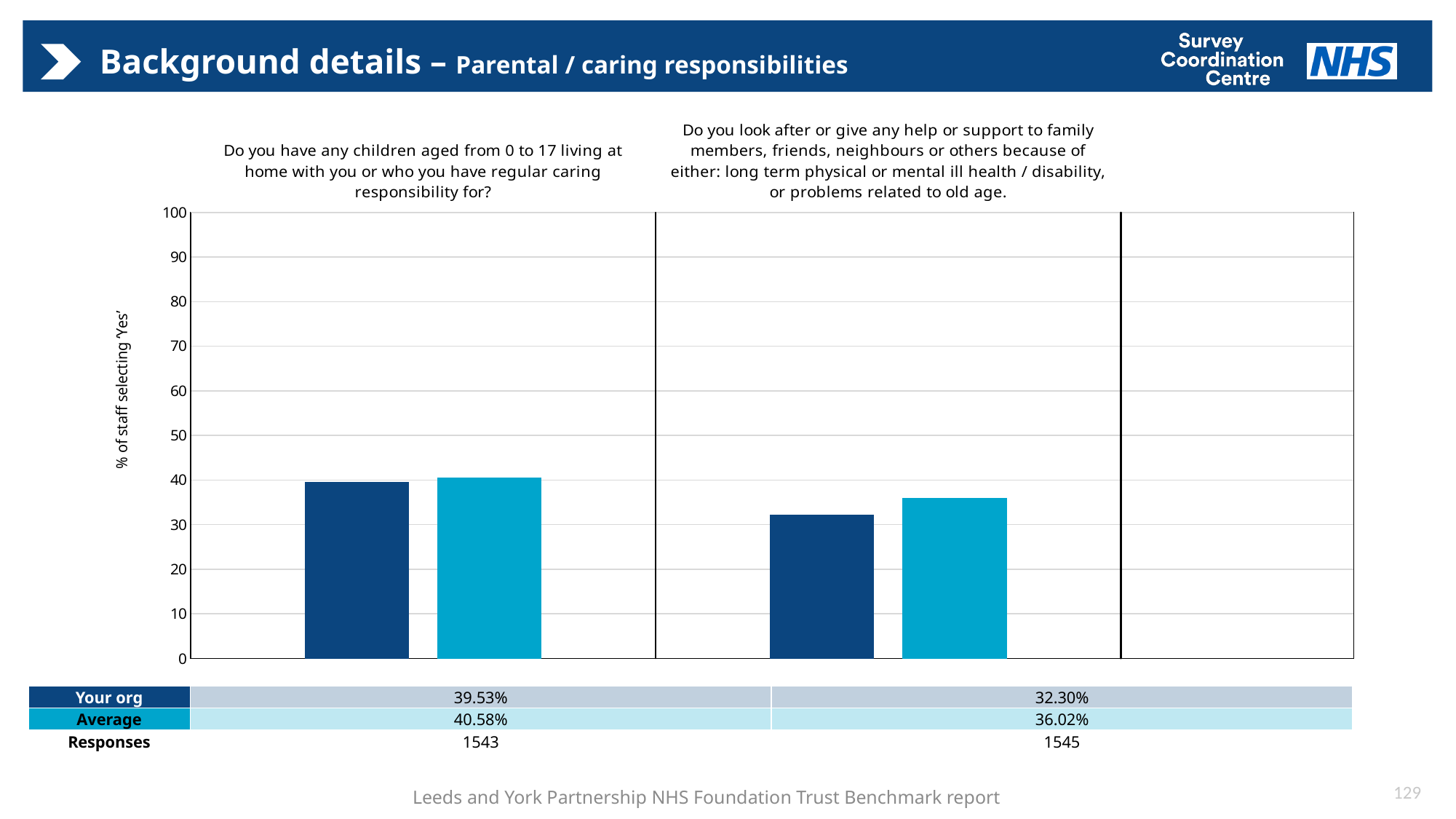
How many responses were there for the question about children aged 0 to 17? 1543 How many responses were there for the question about looking after or supporting family members, friends, neighbours or others? 1545 What is the 'Your org' value for the question about having children aged 0 to 17 living at home or with regular caring responsibility? 39.53% What is the 'Average' value for the question about looking after or supporting family members, friends, neighbours or others because of ill health, disability or old age? 36.02% For the question about looking after or supporting family members, friends, neighbours or others, which is larger: 'Your org' or 'Average'? Average What is the 'Your org' value for the question about looking after or supporting family members, friends, neighbours or others because of ill health, disability or old age? 32.30% What is the difference between the 'Average' and 'Your org' values for the question about children aged 0 to 17? 1.05% What is the difference between the 'Average' and 'Your org' values for the question about looking after or supporting family members, friends, neighbours or others? 3.72% Which question has the lowest 'Your org' value? Do you look after or give any help or support to family members, friends, neighbours or others because of either: long term physical or mental ill health / disability, or problems related to old age. What is the 'Average' value for the question about having children aged 0 to 17 living at home or with regular caring responsibility? 40.58% How many series does the chart show? 2 What kind of chart is shown on the slide? Bar chart